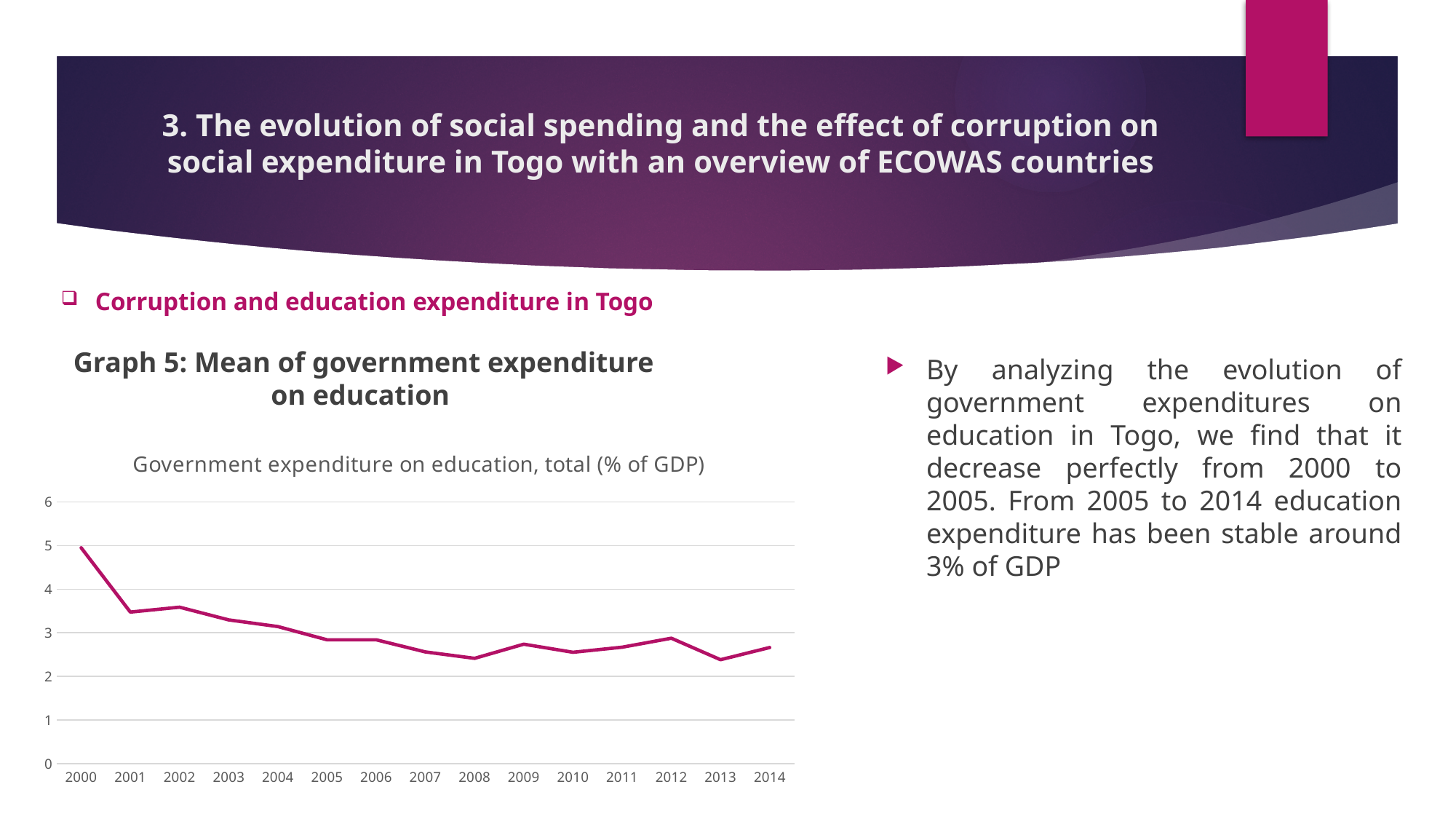
What is the title shown above the plotted line in the chart? Government expenditure on education, total (% of GDP) Is the value for 2000 greater or less than 4? greater Does the value rise or fall from 2000 to 2005? fall Is the value for 2008 greater or less than 3? less How many years are plotted along the x axis of the chart? 15 Which year has the highest government expenditure on education in the chart? 2000 Is the value for 2002 greater or less than 3? greater What kind of chart is shown on the slide? line chart Which year has the larger value, 2000 or 2001? 2000 Which year has the larger value, 2002 or 2005? 2002